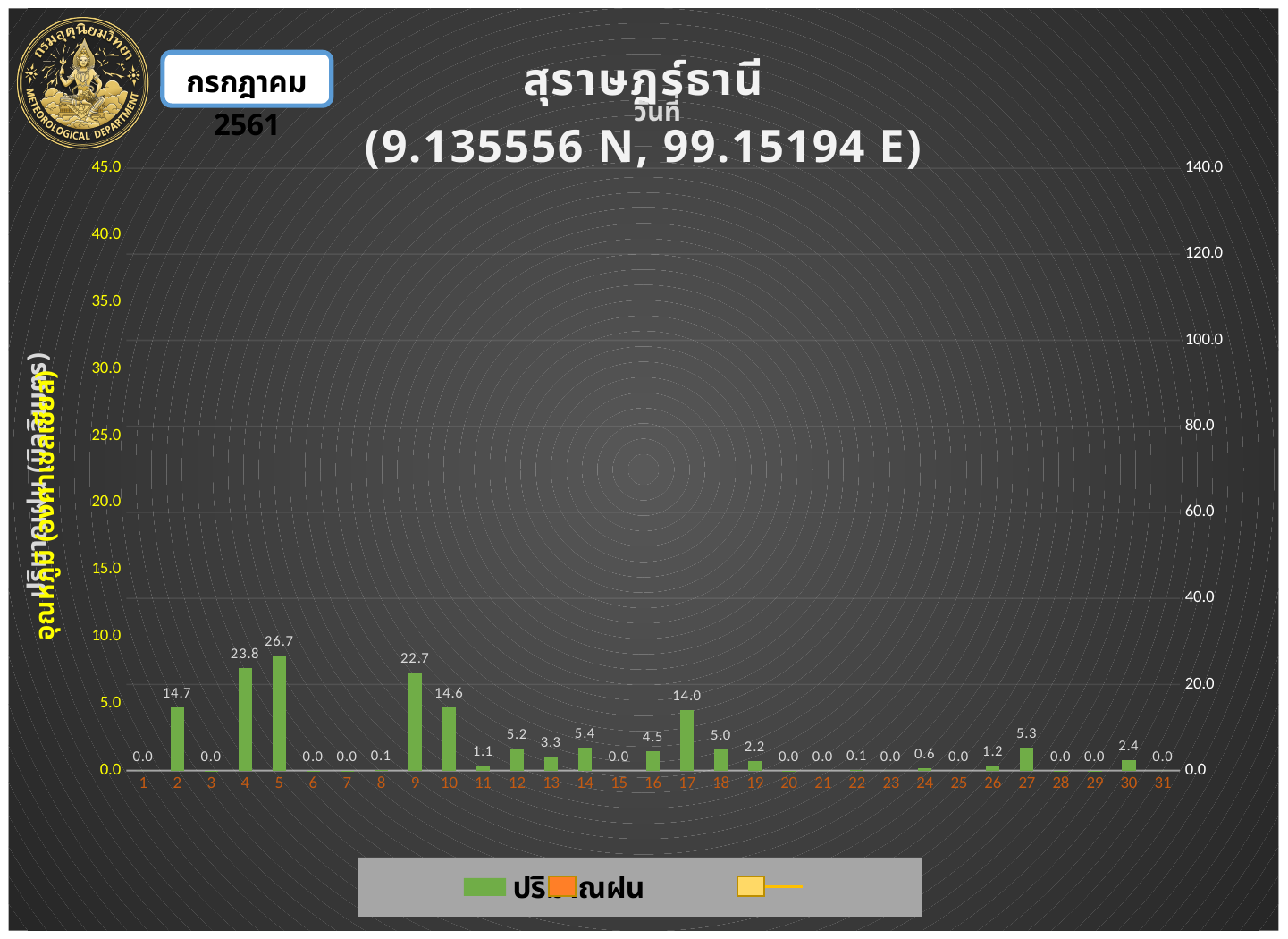
What is the difference between the rainfall values for day 5 and day 4? 2.9 What is the rainfall value shown for day 27? 5.3 What is the rainfall value shown for day 17? 14.0 What is the rainfall value shown for day 5? 26.7 What is the difference between the rainfall values for day 9 and day 10? 8.1 What colour are the rainfall (ปริมาณฝน) bars? green Which day has the highest rainfall value? 5 How many days are shown on the x axis? 31 What kind of chart is used to show the rainfall values? bar chart What is the rainfall value shown for day 9? 22.7 Which is larger, the rainfall value for day 9 or for day 17? day 9